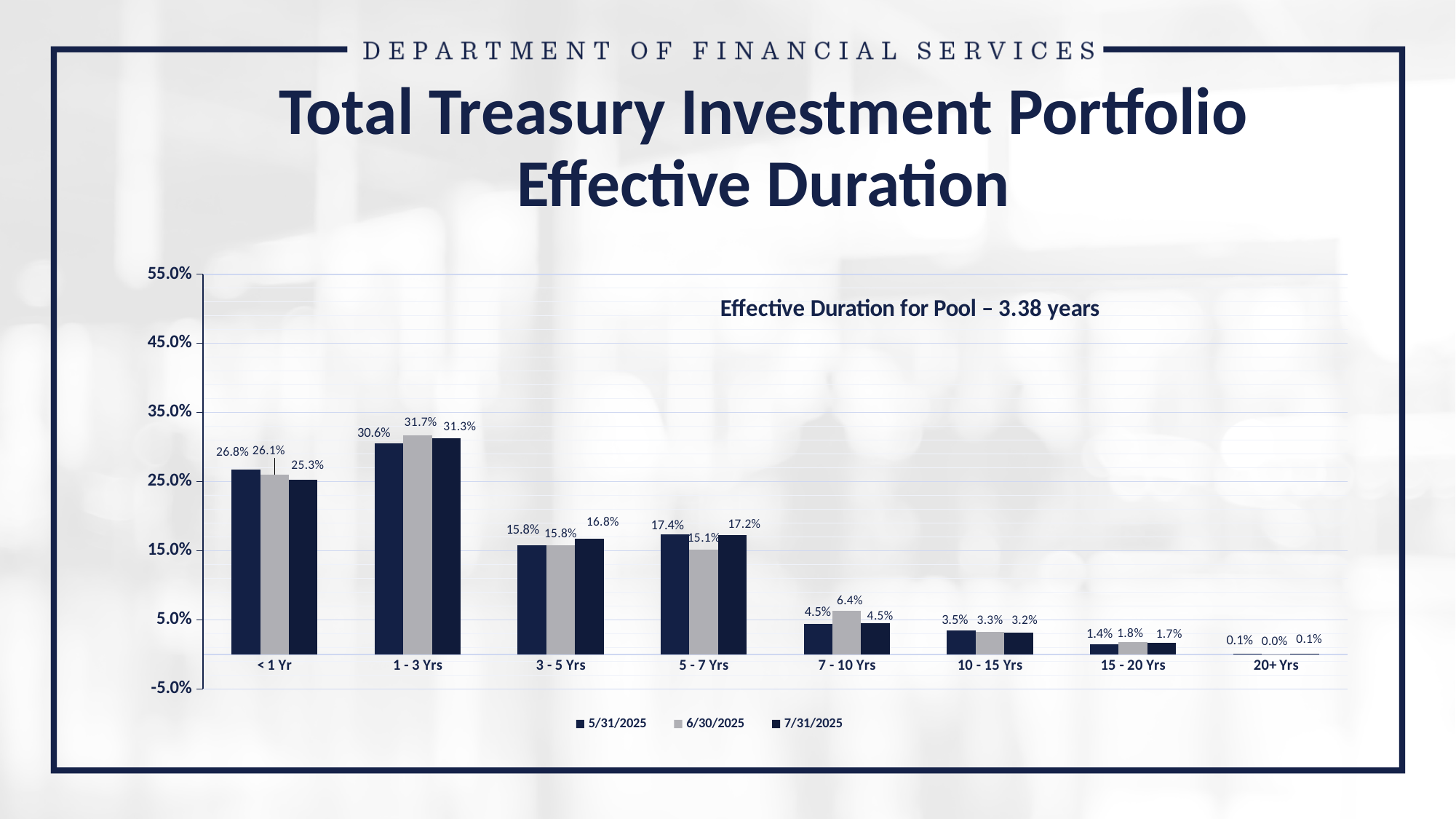
What is the value for the 7 - 10 Yrs category in the 6/30/2025 series? 6.4% What is the value for the 1 - 3 Yrs category in the 6/30/2025 series? 31.7% What kind of chart is shown on the slide? Bar chart Which is larger for the 5 - 7 Yrs category: the 5/31/2025 value or the 6/30/2025 value? 5/31/2025 What effective duration for the pool is stated on the chart? 3.38 years Do the 7/31/2025 values generally rise or fall moving from the 1 - 3 Yrs category to the 20+ Yrs category? Fall How many series does the legend list? 3 What is the difference between the 5/31/2025 and 7/31/2025 values for the < 1 Yr category? 1.5% How many maturity categories are shown on the x axis? 8 Which category has the lowest value in the 7/31/2025 series? 20+ Yrs What is the value for the 5 - 7 Yrs category in the 7/31/2025 series? 17.2% Which category has the highest value in the 5/31/2025 series? 1 - 3 Yrs